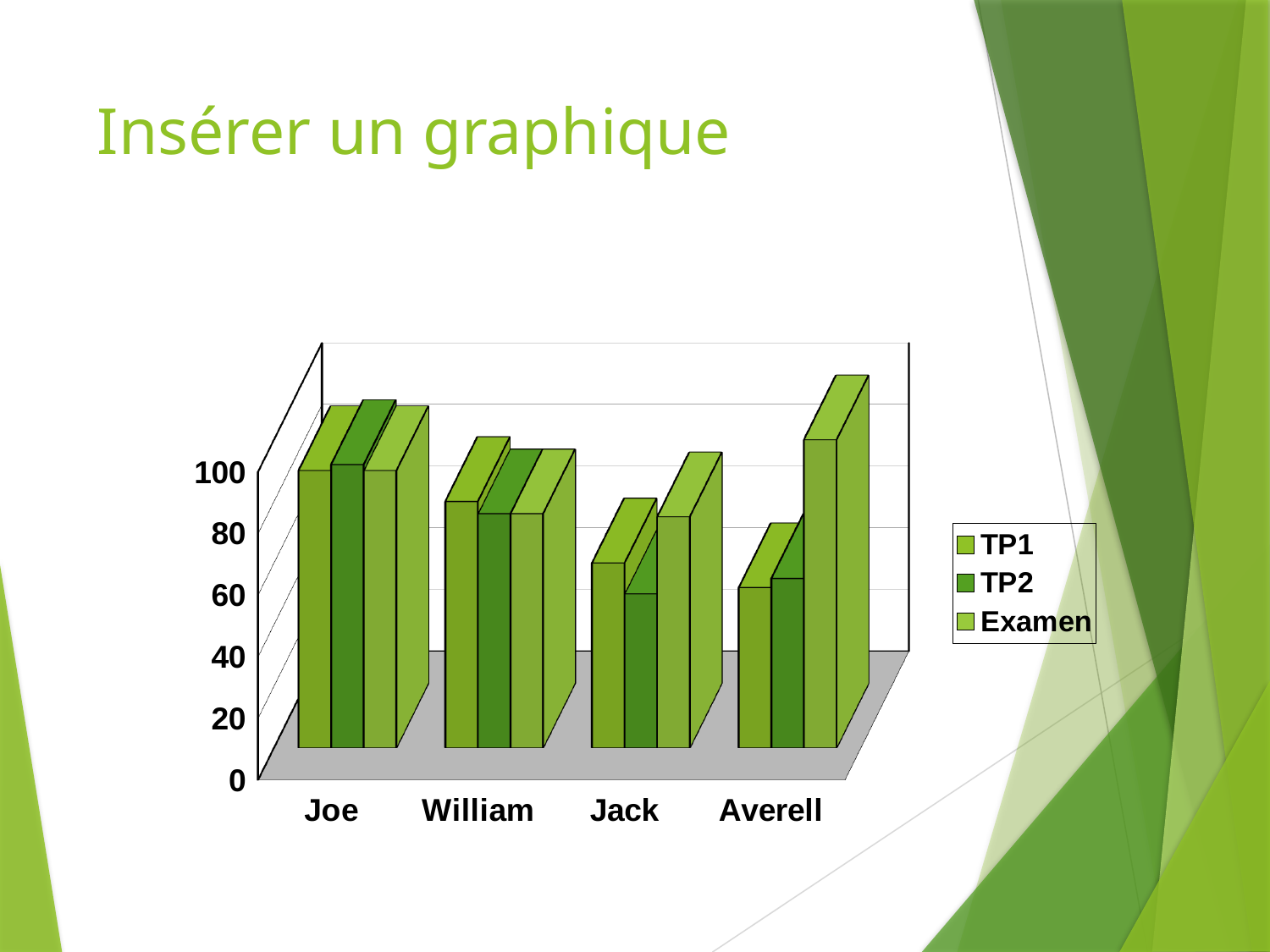
How many series does the legend list? 3 What are the series names listed in the legend? TP1, TP2, Examen How many categories (students) are shown on the x axis? 4 For Averell, which series has the highest bar? Examen For Jack, which series has the lowest bar? TP2 Which student has the highest Examen bar? Averell Which is larger, the TP1 value for Joe or the TP1 value for Jack? Joe What kind of chart is shown on the slide? bar chart Is the TP2 value for Jack greater or less than 80? less Do the TP1 values rise or fall from Joe to Averell along the x axis? fall